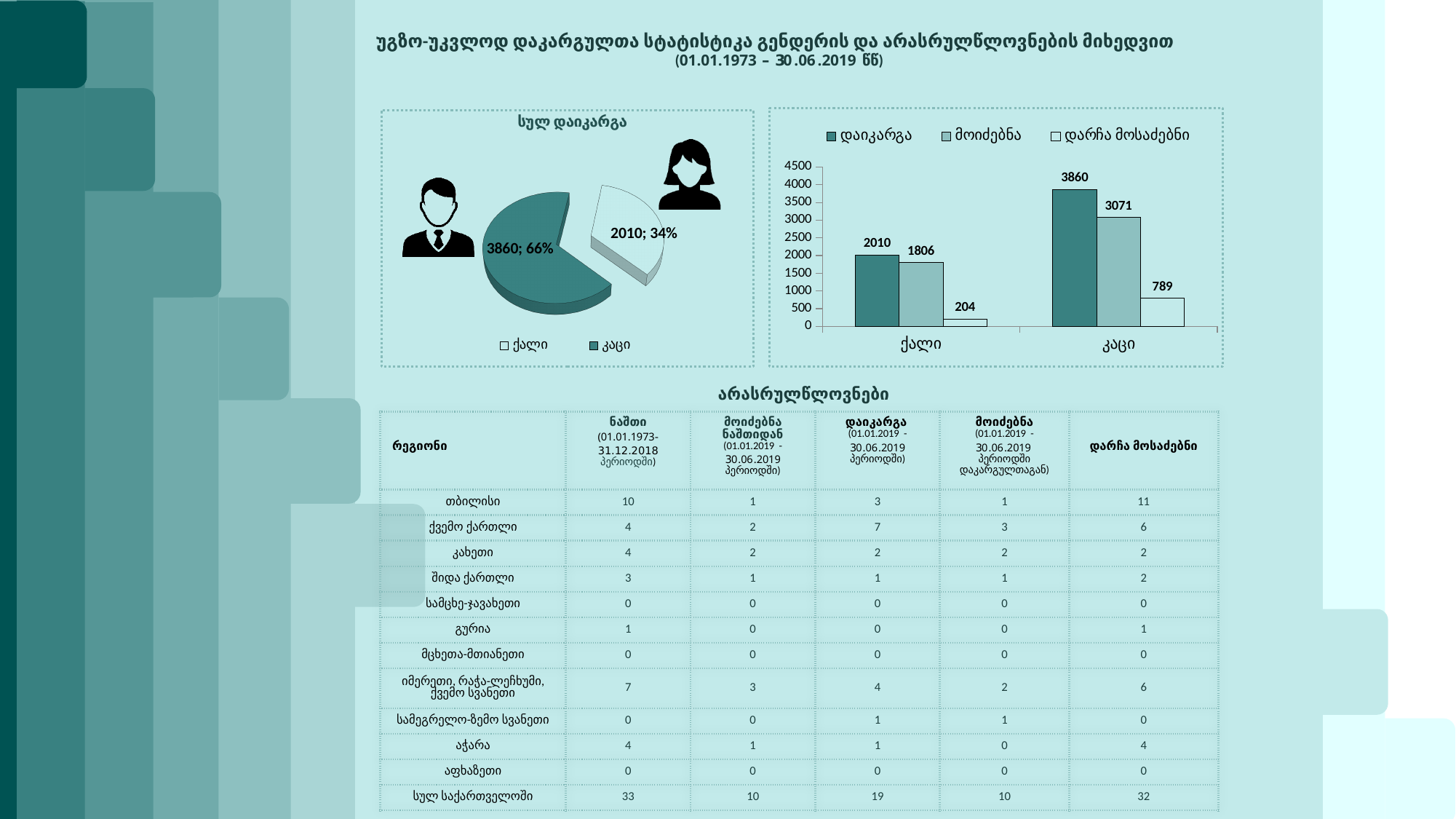
In the bar chart on the right, what is the difference between დაიკარგა and მოიძებნა for კაცი? 789 In the pie chart titled "სულ დაიკარგა", how many slices are there? 2 In the bar chart on the right, which category has the highest დარჩა მოსაძებნი value? კაცი In the bar chart on the right, what is the value of დაიკარგა for ქალი? 2010 In the pie chart titled "სულ დაიკარგა", what value and share are shown for კაცი? 3860; 66% In the pie chart titled "სულ დაიკარგა", which slice is larger, ქალი or კაცი? კაცი In the bar chart on the right, how many series does the legend list? 3 In the pie chart titled "სულ დაიკარგა", what share of the pie does ქალი have? 34% In the bar chart on the right, what is the difference between the დარჩა მოსაძებნი values for კაცი and ქალი? 585 What type of chart is the chart on the right of the slide? bar chart In the bar chart on the right, what is the value of მოიძებნა for კაცი? 3071 In the bar chart on the right, what is the value of დარჩა მოსაძებნი for ქალი? 204